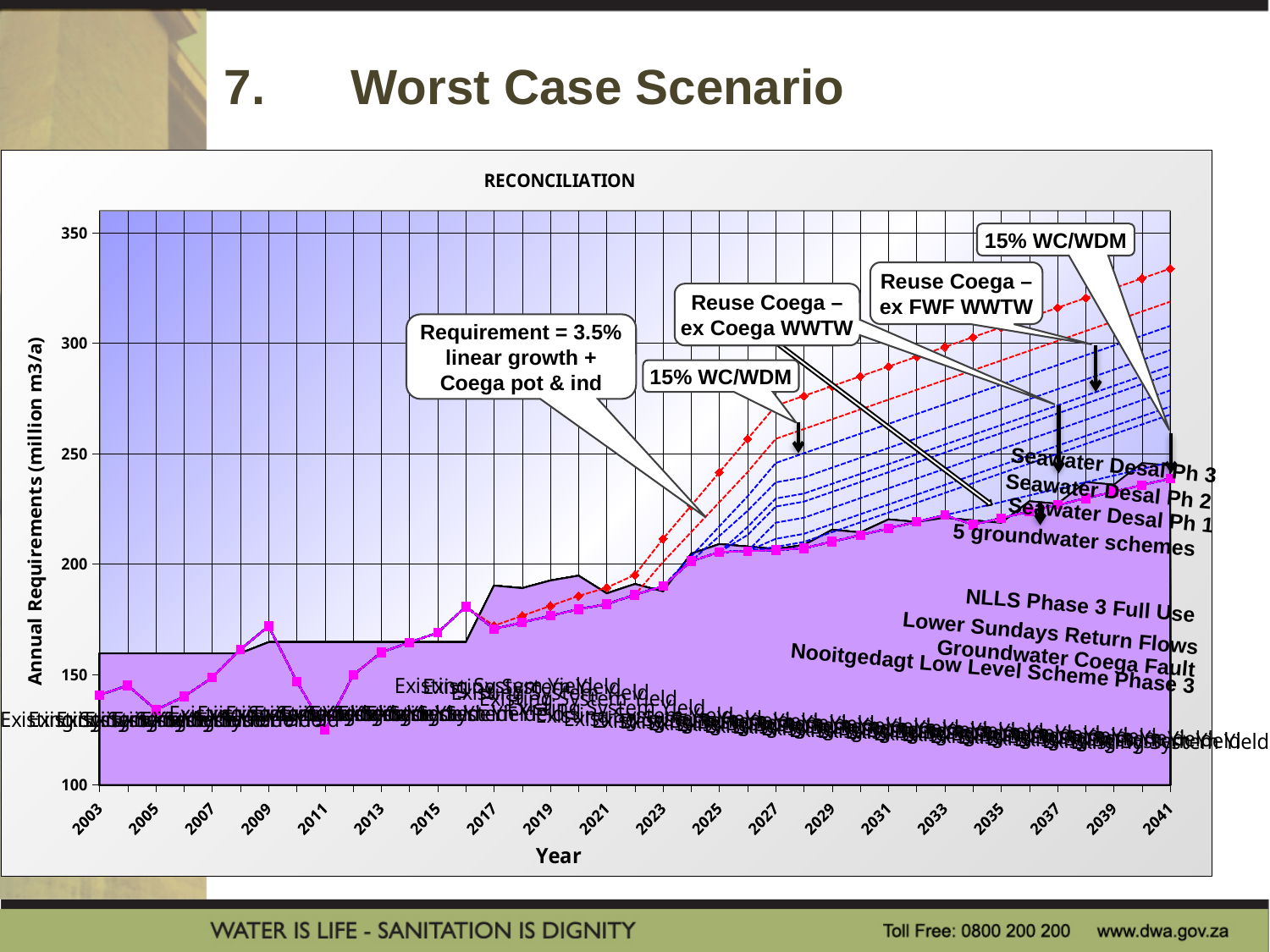
What kind of chart is shown on the slide? line chart Is the value of the magenta line in 2041 greater or less than 200? greater Is the value of the magenta line in 2011 greater or less than 150? less Is the value of the magenta line in 2017 greater or less than 200? less What is the label of the vertical axis of the chart? Annual Requirements (million m3/a) Does the top red dashed requirement line rise or fall from 2017 to 2041? rise How many year labels are shown along the x axis? 20 What is the title of the chart? RECONCILIATION